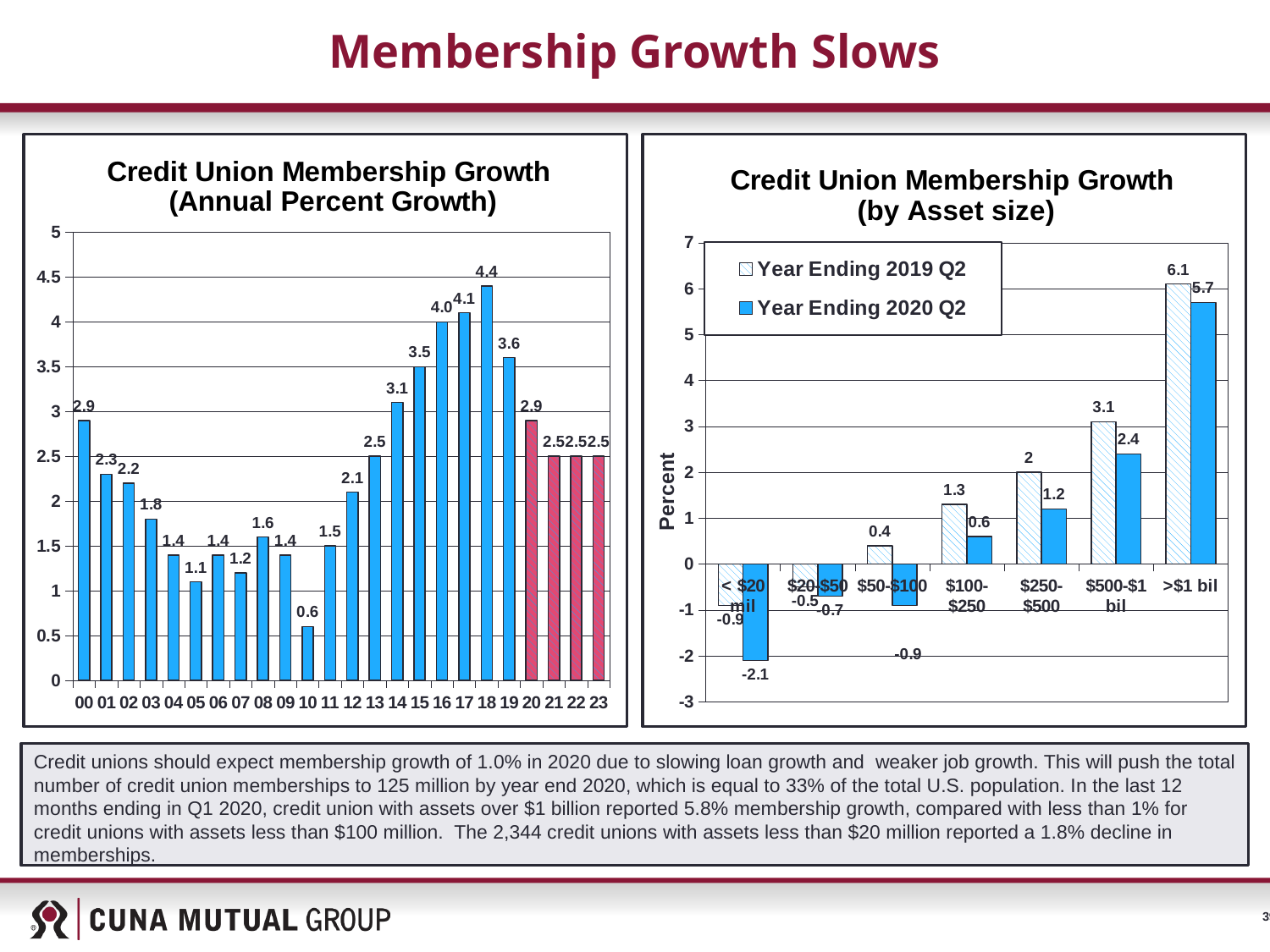
In the chart 'Credit Union Membership Growth (Annual Percent Growth)', what is the difference between the values for 19 and 20? 0.7 What kind of chart is 'Credit Union Membership Growth (by Asset size)'? bar chart In the chart 'Credit Union Membership Growth (by Asset size)', which is larger for $100-$250: Year Ending 2019 Q2 or Year Ending 2020 Q2? Year Ending 2019 Q2 In the chart 'Credit Union Membership Growth (Annual Percent Growth)', which year has the lowest value? 10 In the chart 'Credit Union Membership Growth (Annual Percent Growth)', what is the value for 18? 4.4 In the chart 'Credit Union Membership Growth (by Asset size)', how many series does the legend list? 2 In the chart 'Credit Union Membership Growth (Annual Percent Growth)', do the values rise or fall from 14 to 18? rise In the chart 'Credit Union Membership Growth (by Asset size)', what is the Year Ending 2020 Q2 value for < $20 mil? -2.1 In the chart 'Credit Union Membership Growth (Annual Percent Growth)', which year has the highest value? 18 In the chart 'Credit Union Membership Growth (by Asset size)', which asset size has the highest Year Ending 2020 Q2 value? >$1 bil In the chart 'Credit Union Membership Growth (by Asset size)', what is the Year Ending 2019 Q2 value for $500-$1 bil? 3.1 In the chart 'Credit Union Membership Growth (Annual Percent Growth)', how many years are shown on the x axis? 24